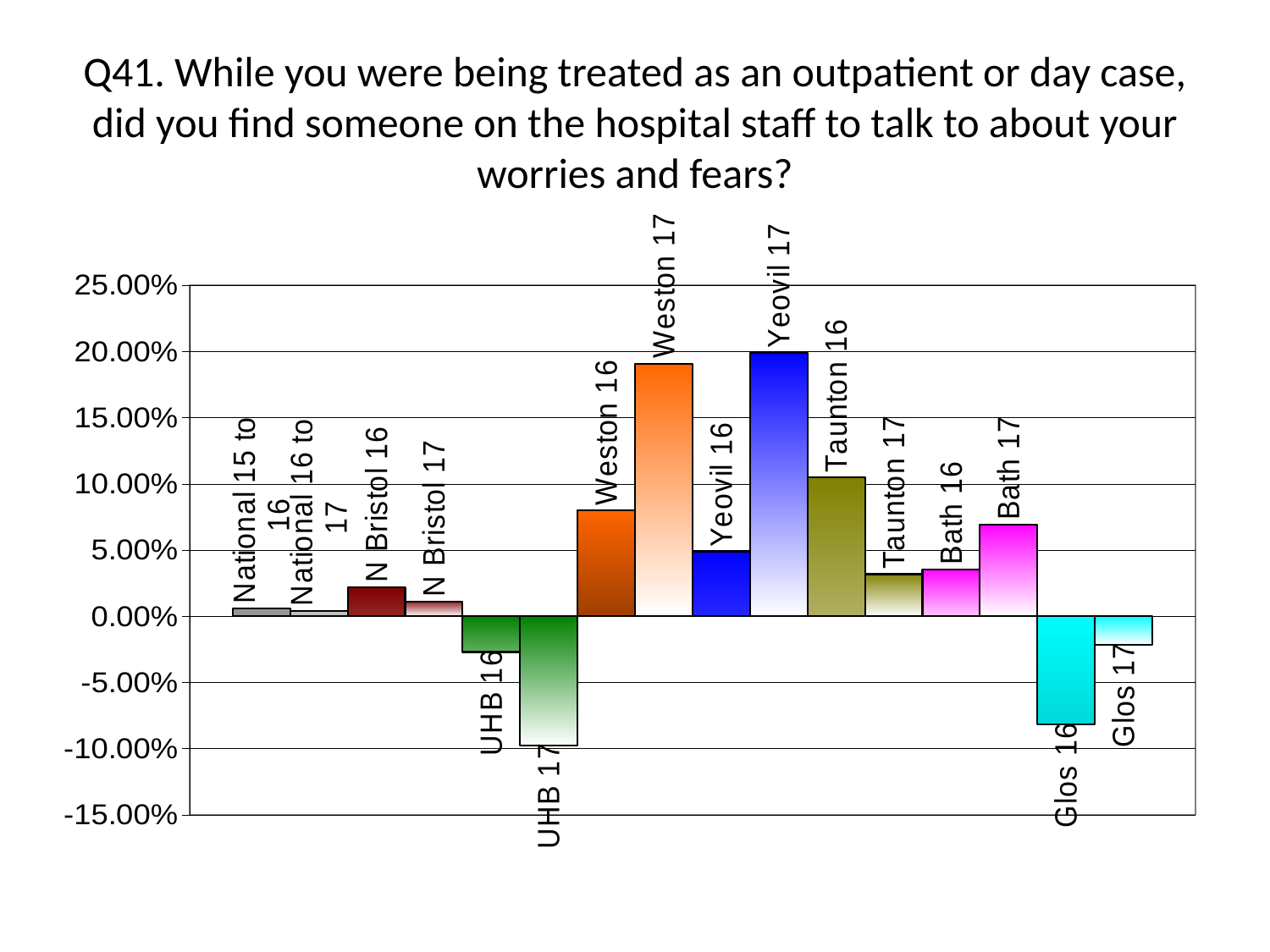
Which is larger, the value for Weston 16 or the value for Weston 17? Weston 17 Which is larger, the value for Taunton 16 or the value for Taunton 17? Taunton 16 Is the value for Bath 17 greater or less than 5.00%? greater Is the value for Glos 16 greater or less than -5.00%? less Is the value for Yeovil 16 greater or less than 10.00%? less What question number is referenced in the chart title? Q41 How many bars (categories) are plotted in the chart? 16 Which category has the lowest value in the chart? UHB 17 What kind of chart is shown on the slide? bar chart Which category has the highest value in the chart? Yeovil 17